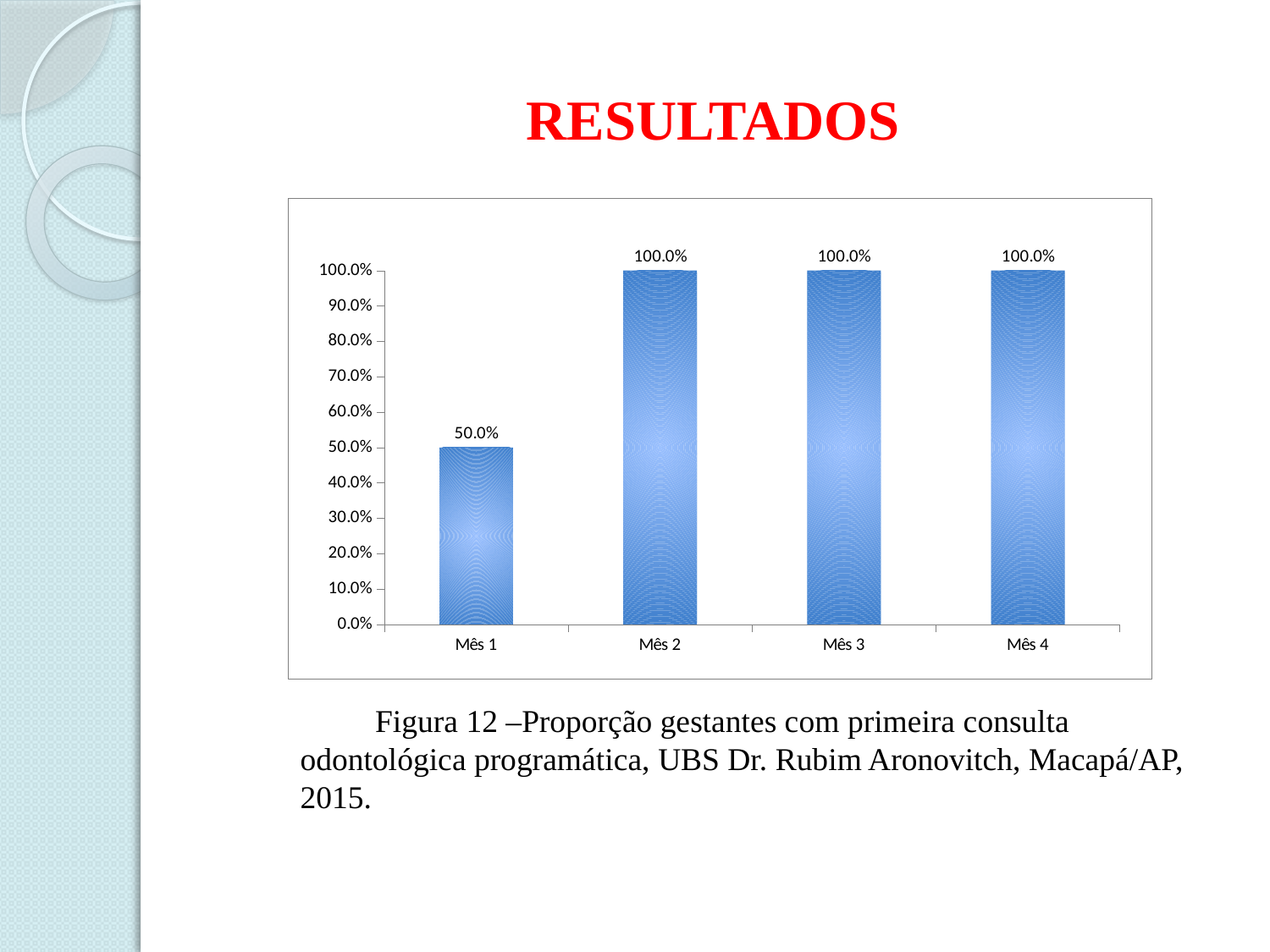
Do the values rise or fall from Mês 1 to Mês 2? rise How many categories have a value of 100.0%? 3 Which is larger, the value for Mês 1 or the value for Mês 2? Mês 2 What is the value for Mês 1? 50.0% How many categories are shown on the x axis? 4 What is the figure number given in the caption below the chart? Figura 12 Is the value for Mês 1 greater or less than 60.0%? less What kind of chart is shown on the slide? bar chart What is the value for Mês 3? 100.0% What is the difference between the values for Mês 2 and Mês 1? 50.0% Which category has the lowest value? Mês 1 What is the value for Mês 4? 100.0%